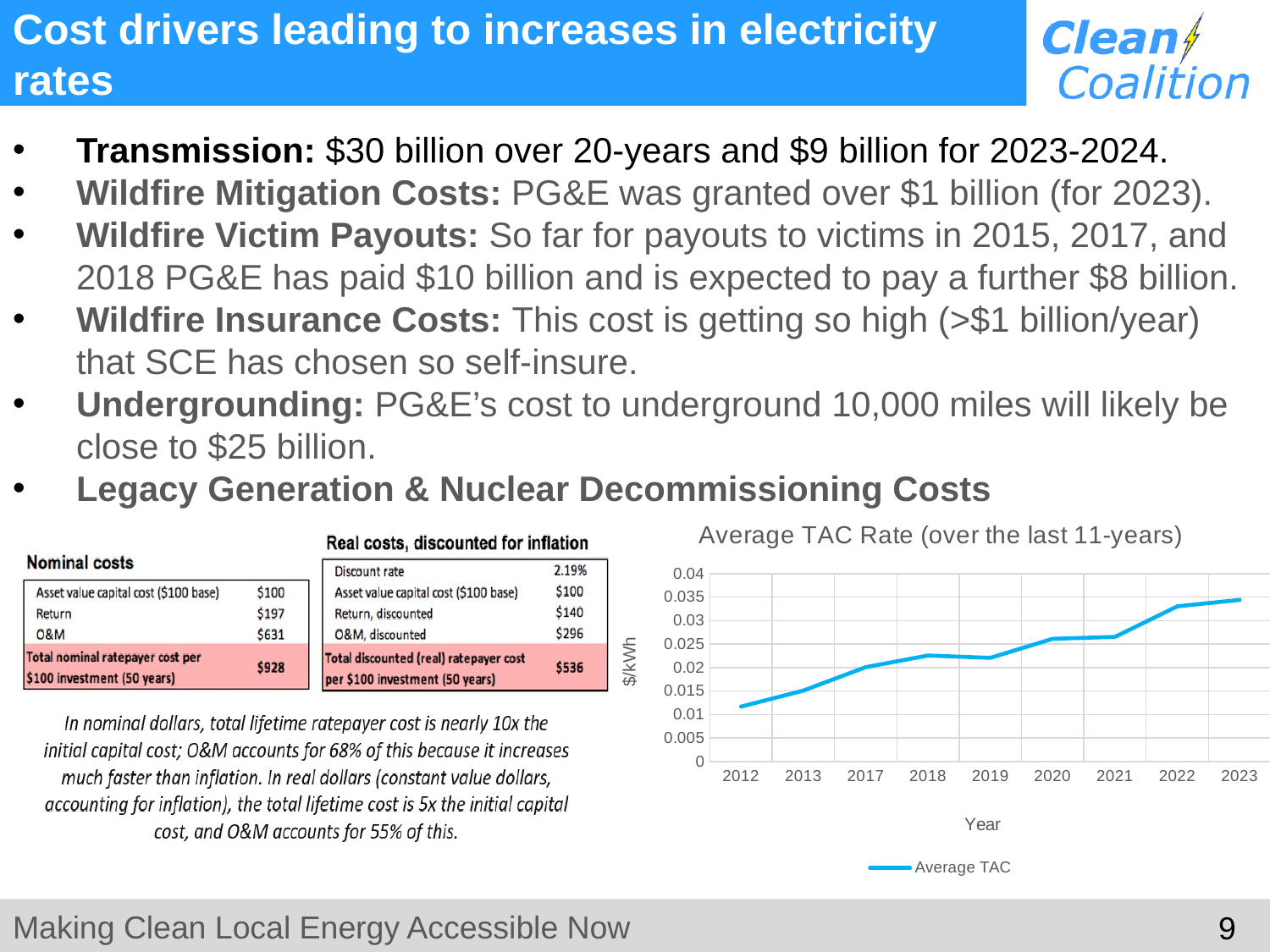
What is the label of the x axis of the Average TAC Rate chart? Year Is the Average TAC rate for 2023 greater or less than 0.03 $/kWh? greater Is the Average TAC rate for 2012 greater or less than 0.015 $/kWh? less What unit is shown on the y axis of the Average TAC Rate chart? $/kWh Does the Average TAC rate generally rise or fall from 2012 to 2023? rise What kind of chart is the "Average TAC Rate (over the last 11-years)" chart? line chart Is the Average TAC rate for 2013 greater or less than 0.02 $/kWh? less How many years are plotted on the x axis of the Average TAC Rate chart? 9 Which year has the larger Average TAC rate, 2012 or 2023? 2023 Which year has the lowest Average TAC rate in the chart? 2012 How many series does the legend of the Average TAC Rate chart list? 1